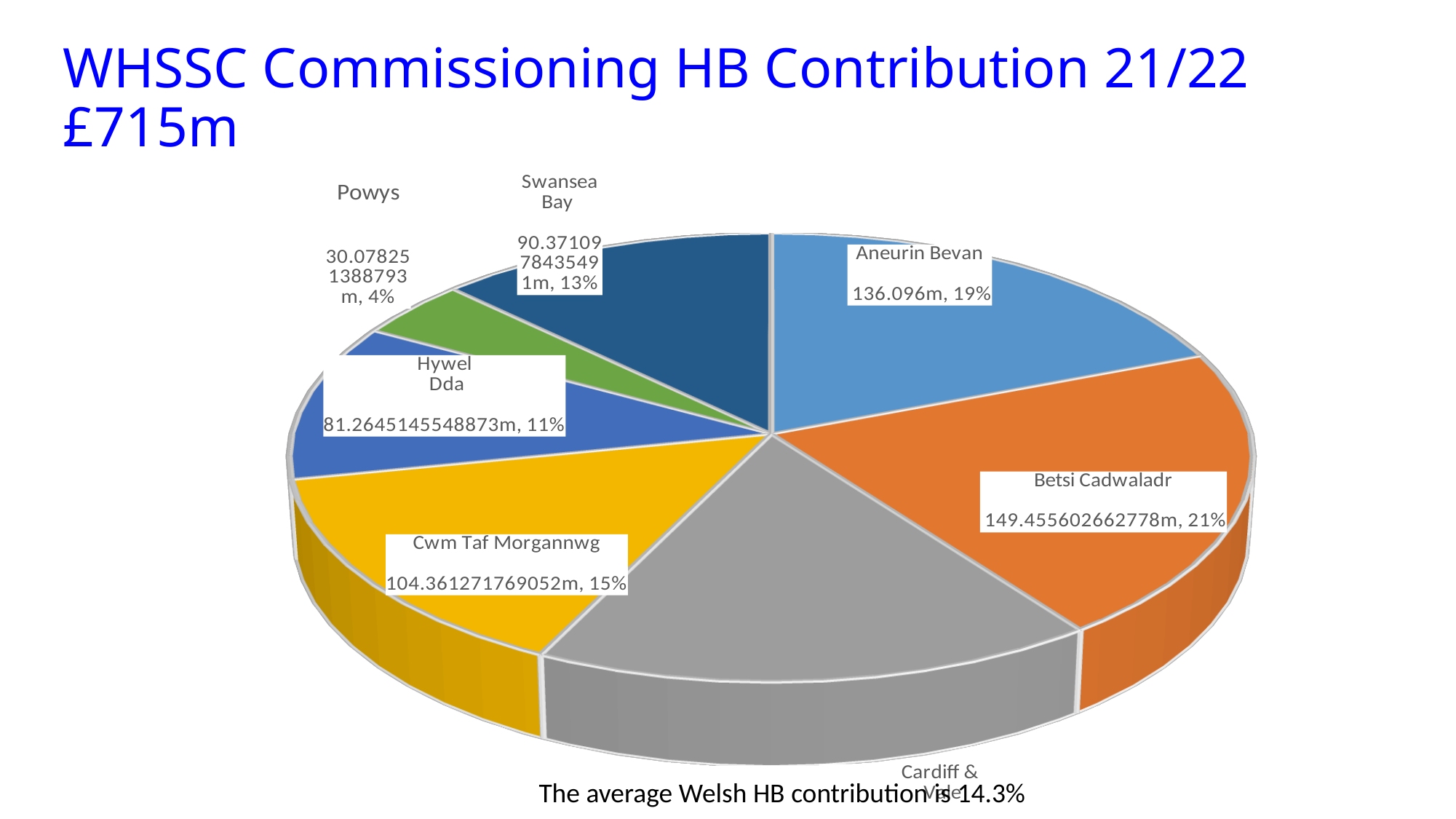
What percentage share of the pie does Powys have? 4% What is the difference in percentage share between Aneurin Bevan (19%) and Hywel Dda (11%)? 8 percentage points How many health boards (slices) are shown in the pie chart? 7 Which has the larger contribution, Aneurin Bevan or Hywel Dda? Aneurin Bevan What percentage share of the pie does Betsi Cadwaladr have? 21% What is the contribution value shown for Aneurin Bevan? 136.096m What is the contribution value shown for Cwm Taf Morgannwg? 104.361271769052m What is the title of the slide? WHSSC Commissioning HB Contribution 21/22 £715m What percentage share of the pie does Hywel Dda have? 11% Which health board has the smallest slice of the pie? Powys What kind of chart is shown on the slide? Pie chart